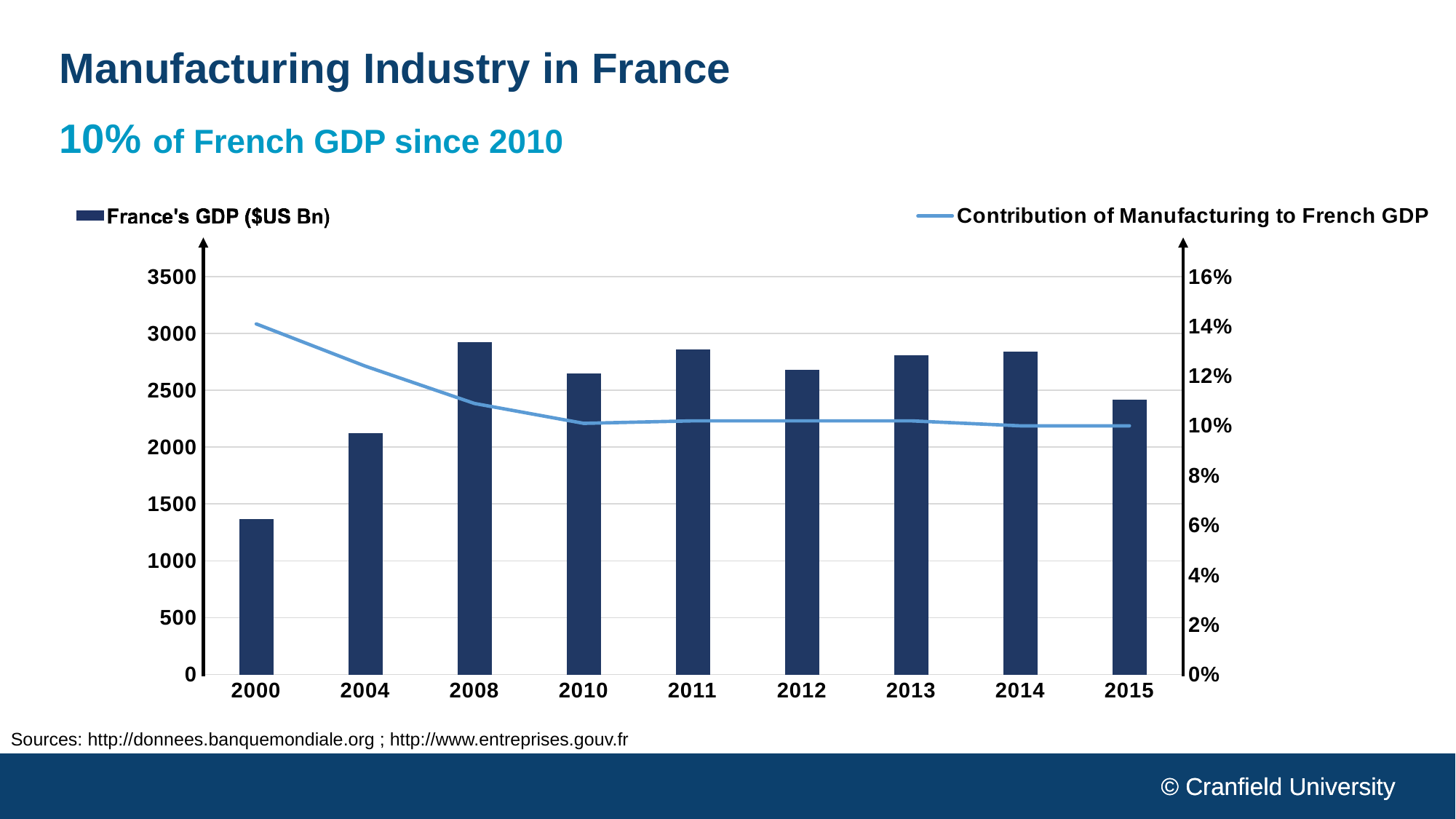
What kind of chart is shown on the slide? A bar chart combined with a line chart How many years are shown on the x axis of the chart? 9 Which year has the lowest bar for France's GDP ($US Bn)? 2000 Is the value of France's GDP ($US Bn) for 2000 greater or less than 1500? less What is the name of the series plotted as a line in the chart? Contribution of Manufacturing to French GDP Is the Contribution of Manufacturing to French GDP in 2000 greater or less than 12%? greater Which year has the highest bar for France's GDP ($US Bn)? 2008 Is the value of France's GDP ($US Bn) for 2015 greater or less than 2500? less Does the Contribution of Manufacturing to French GDP line rise or fall from 2000 to 2010? fall Which year has a larger bar for France's GDP ($US Bn), 2004 or 2010? 2010 How many series does the chart's legend list? 2